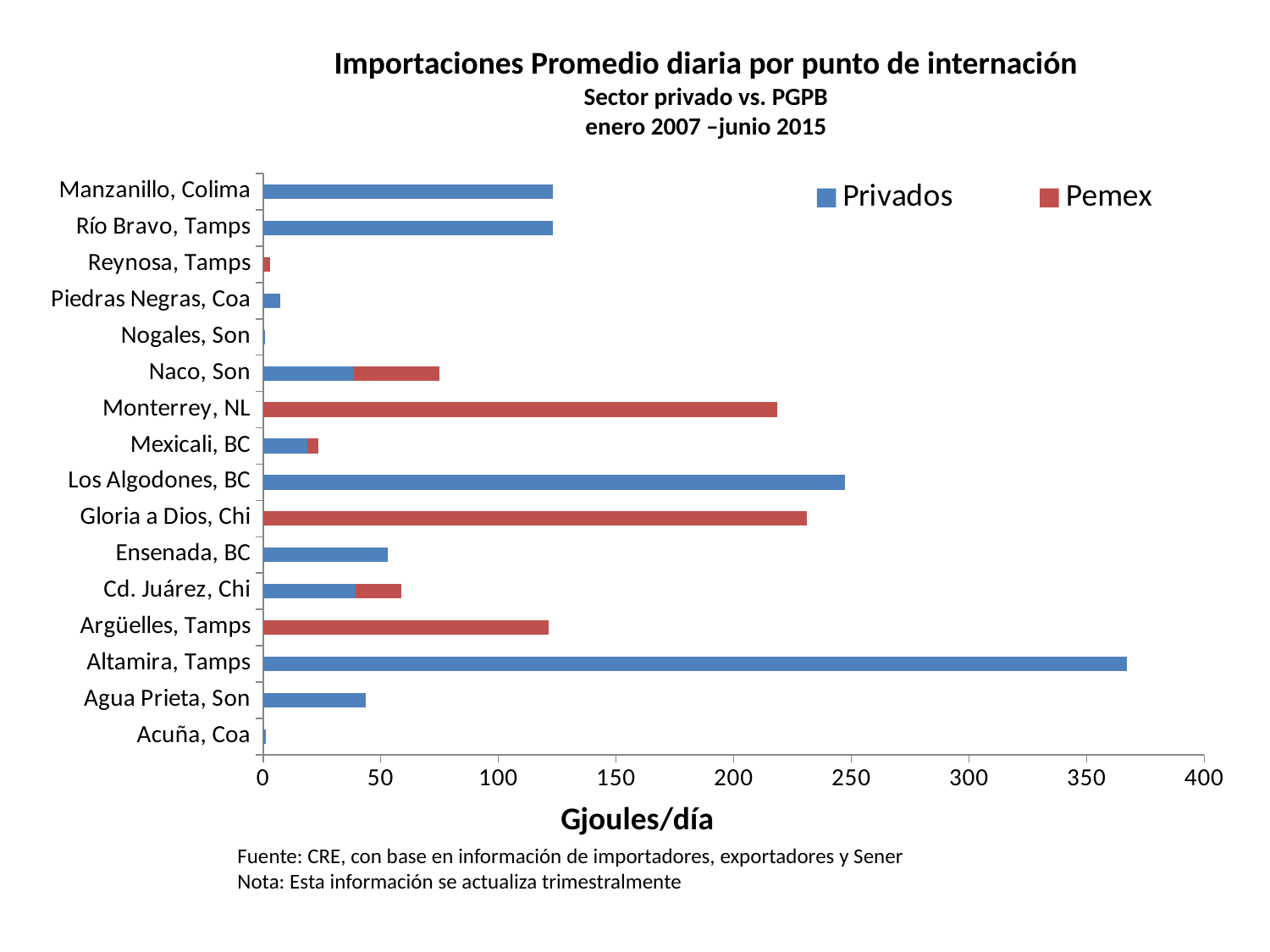
Is the value for Los Algodones, BC greater or less than 200? greater Is the value for Altamira, Tamps greater or less than 350? greater Is the value for Agua Prieta, Son greater or less than 50? less What kind of chart is shown on the slide? bar chart Which is larger, the value for Altamira, Tamps or the value for Los Algodones, BC? Altamira, Tamps How many series does the legend list? 2 Which point of entry has the highest total imports? Altamira, Tamps How many points of entry (categories) are shown on the y axis? 16 Which is larger, the value for Monterrey, NL or the value for Argüelles, Tamps? Monterrey, NL What is the label of the x axis? Gjoules/día